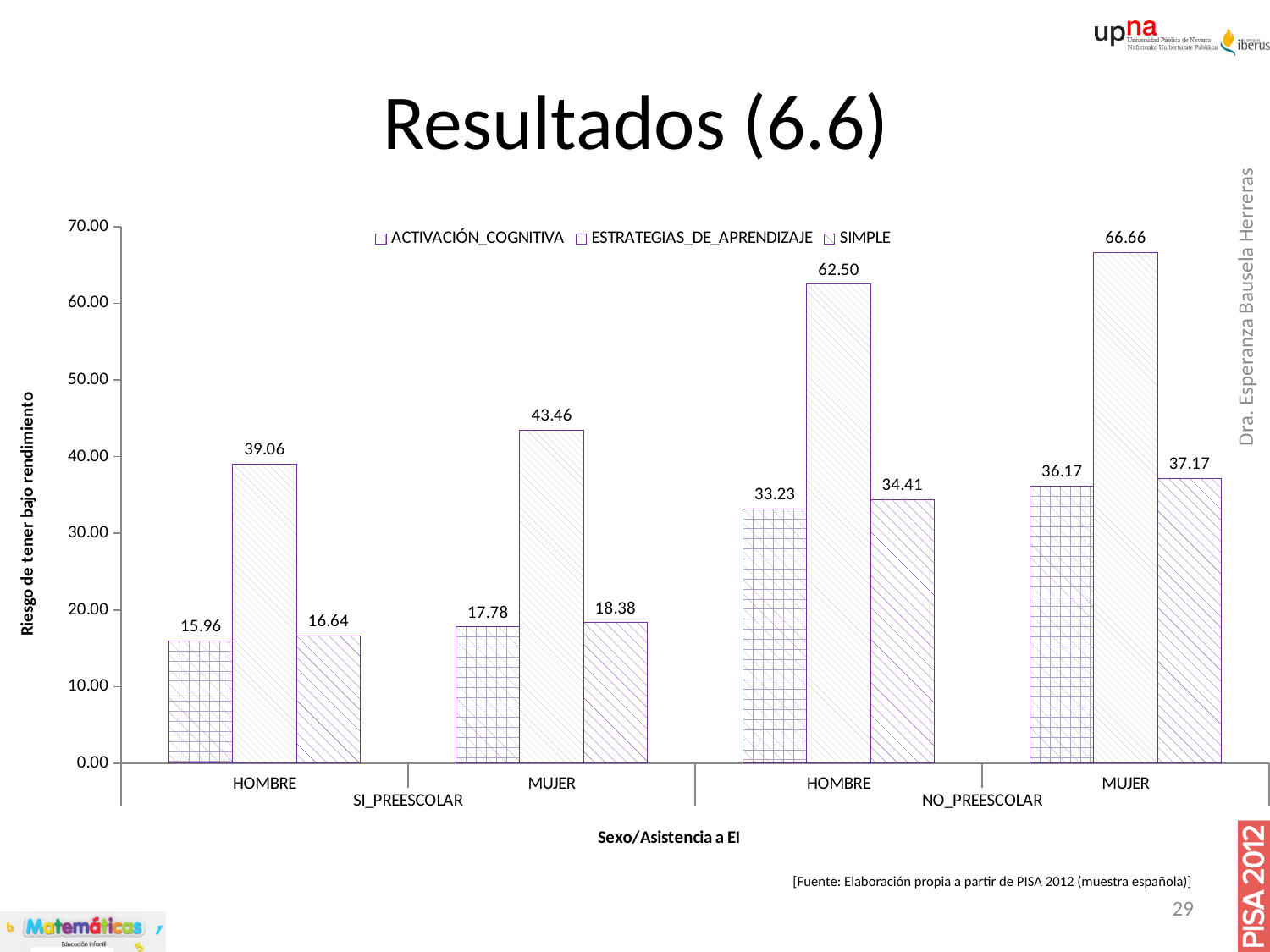
What is the value of ESTRATEGIAS_DE_APRENDIZAJE for MUJER in the NO_PREESCOLAR group? 66.66 Which is larger for HOMBRE in the NO_PREESCOLAR group: ACTIVACIÓN_COGNITIVA or ESTRATEGIAS_DE_APRENDIZAJE? ESTRATEGIAS_DE_APRENDIZAJE Is the ESTRATEGIAS_DE_APRENDIZAJE value for MUJER in the SI_PREESCOLAR group greater or less than 40.00? greater Which group and sex has the highest ESTRATEGIAS_DE_APRENDIZAJE value? NO_PREESCOLAR MUJER How many series does the legend list? 3 What kind of chart is shown on the slide? Bar chart What is the difference between the SIMPLE value and the ACTIVACIÓN_COGNITIVA value for MUJER in the SI_PREESCOLAR group? 0.60 What is the value of ACTIVACIÓN_COGNITIVA for HOMBRE in the SI_PREESCOLAR group? 15.96 What is the value of SIMPLE for HOMBRE in the NO_PREESCOLAR group? 34.41 What is the difference between the ESTRATEGIAS_DE_APRENDIZAJE values for MUJER and HOMBRE in the NO_PREESCOLAR group? 4.16 What is the title of the vertical axis? Riesgo de tener bajo rendimiento Which group and sex has the lowest ACTIVACIÓN_COGNITIVA value? SI_PREESCOLAR HOMBRE